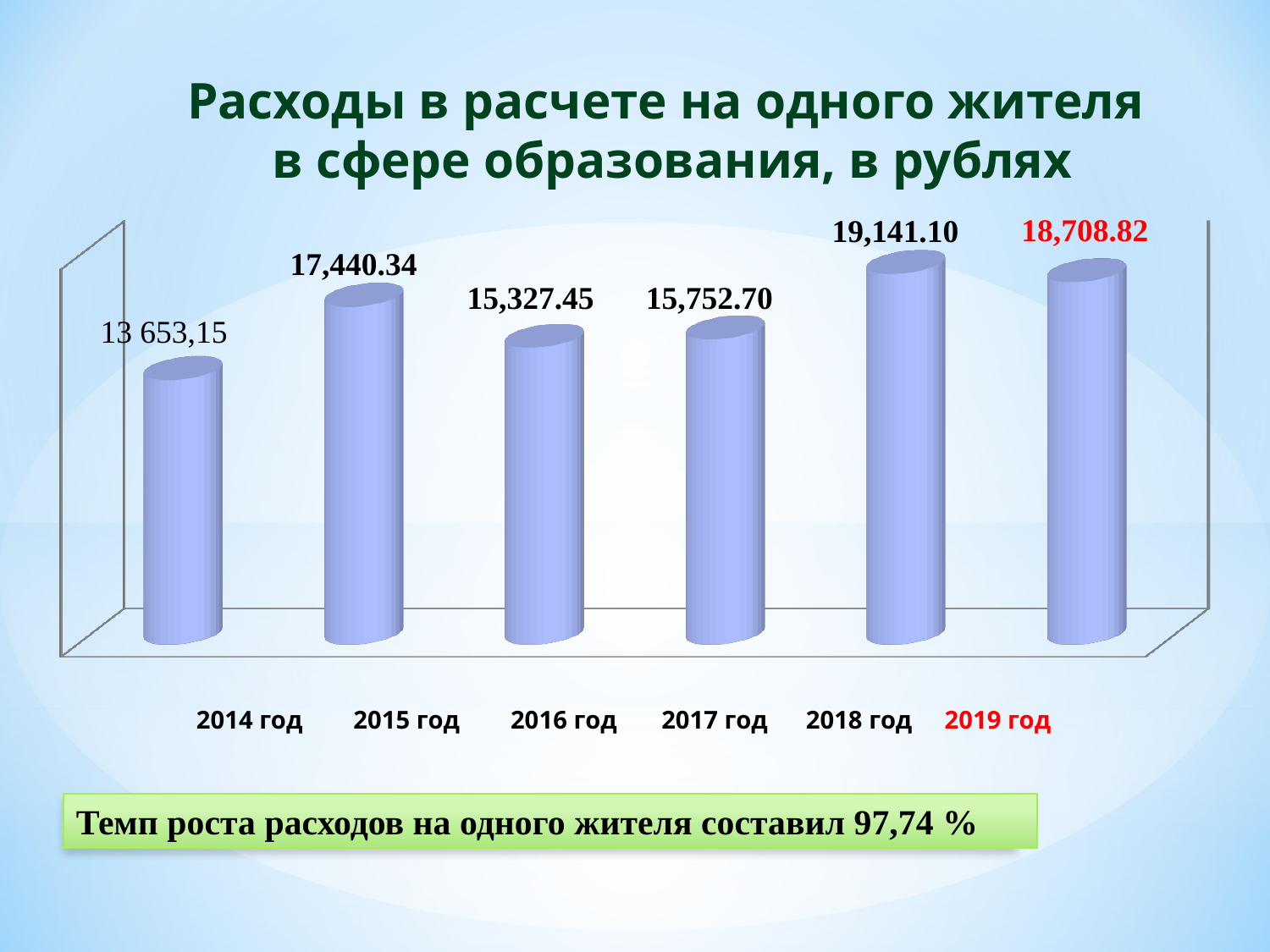
What is the value for 2016 год? 15,327.45 What is the value for 2014 год? 13 653,15 What is the title of the chart? Расходы в расчете на одного жителя в сфере образования, в рублях What is the difference between the values for 2017 год and 2016 год? 425.25 Which year has the highest value? 2018 год What is the value for 2015 год? 17,440.34 Which year has the lowest value? 2014 год What is the difference between the values for 2018 год and 2019 год? 432.28 Which is larger, the value for 2015 год or the value for 2017 год? 2015 год How many years are shown on the chart? 6 What is the value for 2019 год? 18,708.82 What kind of chart is shown on the slide? bar chart